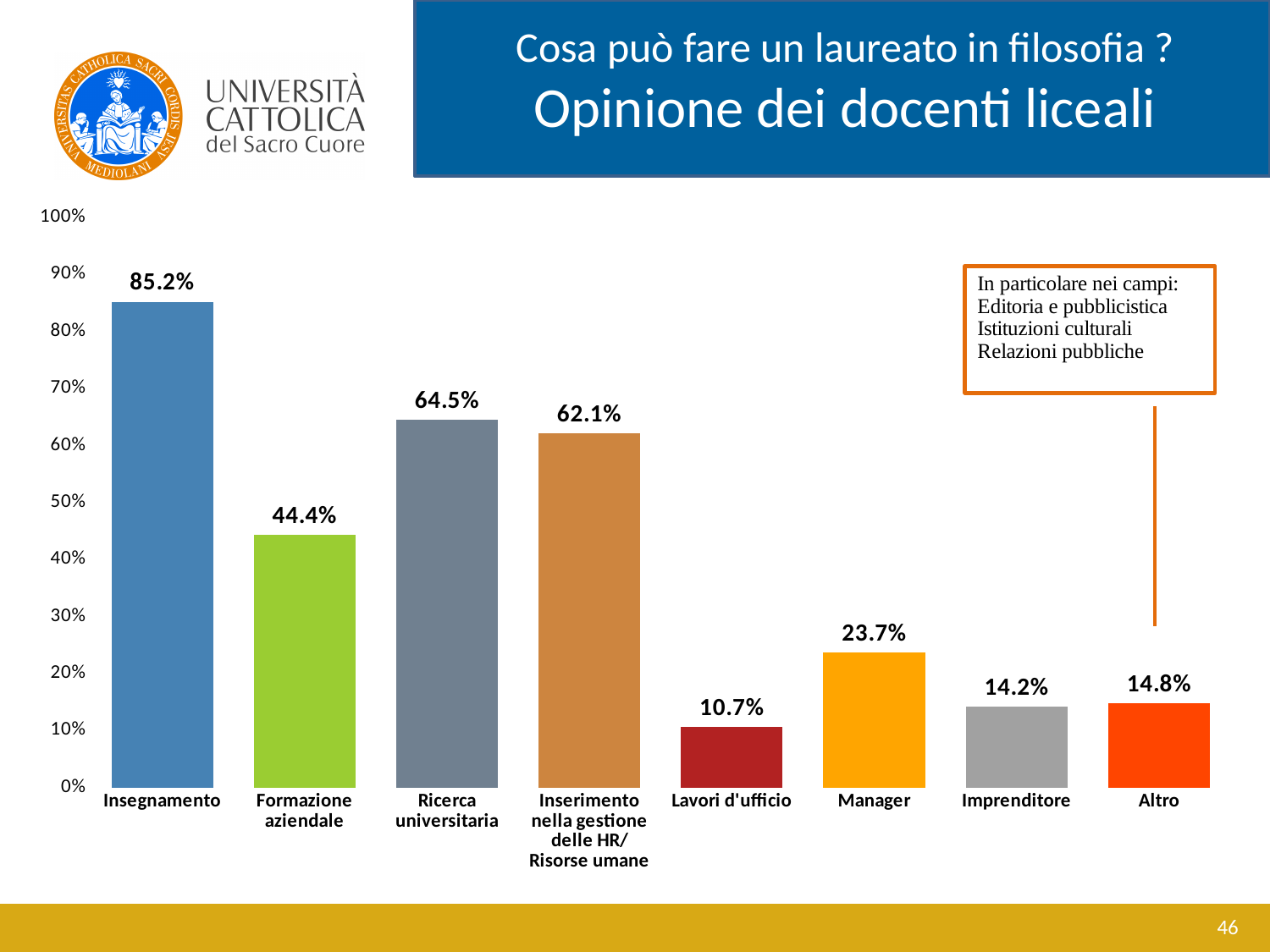
How many categories are shown on the x axis? 8 What is the value for Formazione aziendale? 44.4% What kind of chart is shown on the slide? bar chart Which category has the lowest value? Lavori d'ufficio What is the difference between the values for Ricerca universitaria and Inserimento nella gestione delle HR/Risorse umane? 2.4% Which is larger, the value for Imprenditore or the value for Altro? Altro Is the value for Formazione aziendale greater or less than 50%? less What is the difference between the values for Insegnamento and Formazione aziendale? 40.8% What is the value for Insegnamento? 85.2% Which category has the highest value? Insegnamento What is the value for Manager? 23.7% What is the value for Lavori d'ufficio? 10.7%